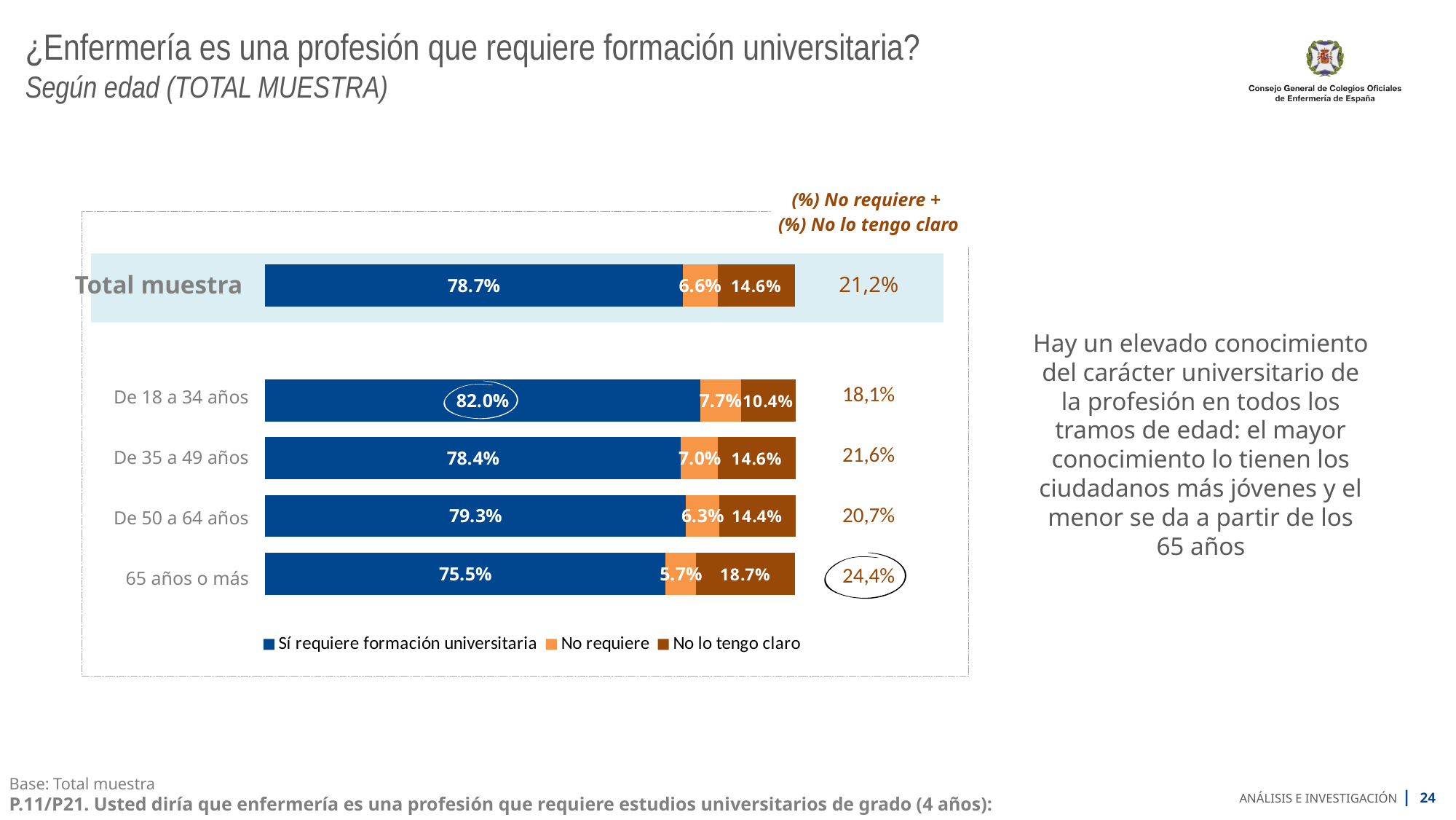
How many series does the legend list? 3 What percentage of respondents aged 18 to 34 (De 18 a 34 años) say nursing does require university training (Sí requiere formación universitaria)? 82.0% Which group has a larger 'Sí requiere formación universitaria' value, De 35 a 49 años or De 50 a 64 años? De 50 a 64 años What is the difference in percentage points between the 'Sí requiere formación universitaria' values for De 18 a 34 años and 65 años o más? 6.5 What kind of chart is shown on the slide? Stacked bar chart How many bars (categories) are shown in the chart, including Total muestra? 5 Which age group has the lowest 'Sí requiere formación universitaria' percentage? 65 años o más What is the combined 'No requiere + No lo tengo claro' percentage shown for Total muestra? 21,2% What is the 'No lo tengo claro' value for the De 35 a 49 años group? 14.6% Which age group has the highest 'Sí requiere formación universitaria' percentage? De 18 a 34 años Which age group has the highest 'No lo tengo claro' percentage? 65 años o más What is the 'No requiere' value for the 65 años o más group? 5.7%